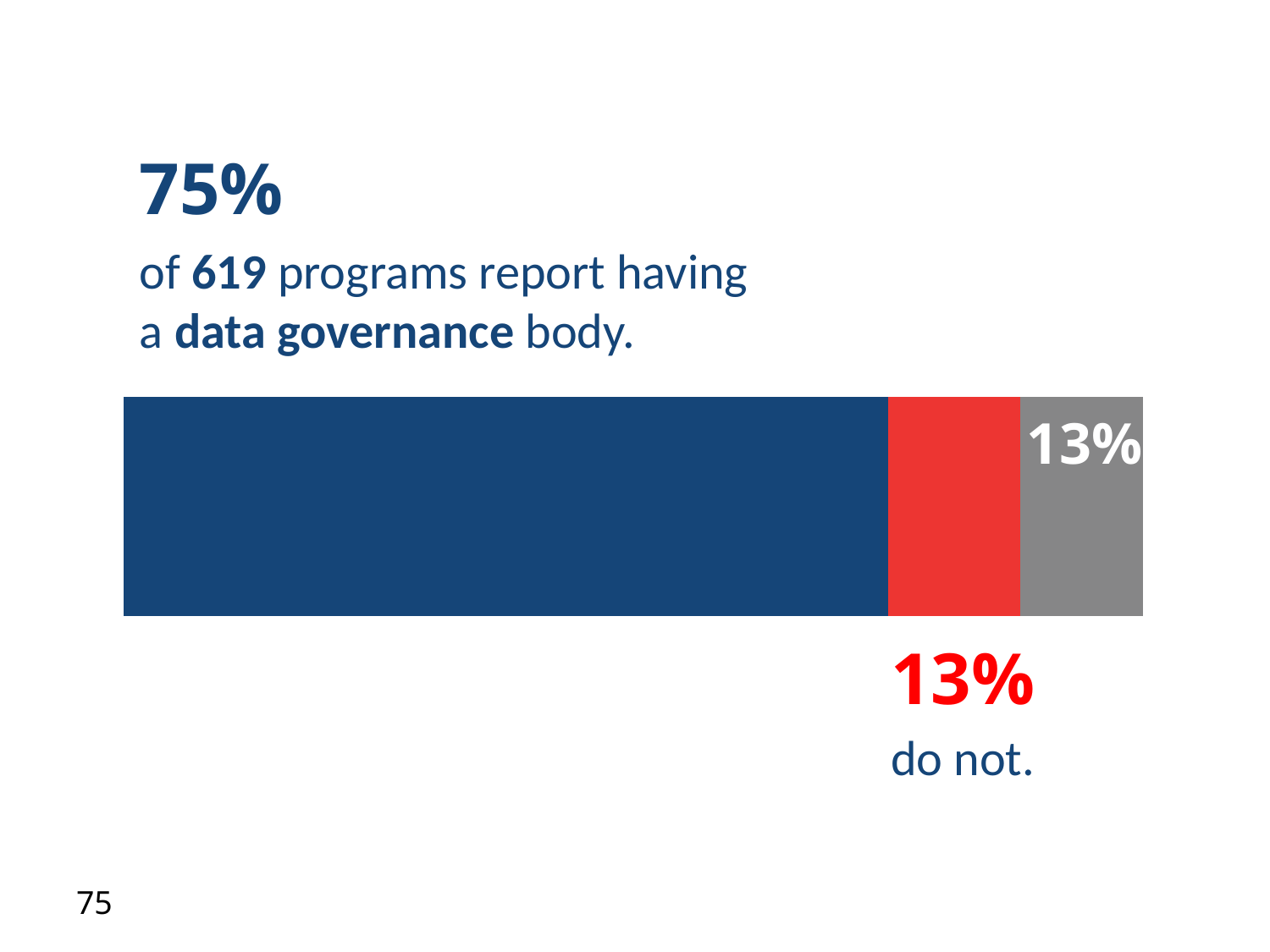
What kind of chart is shown on the slide? bar chart How many segments make up the bar? 3 Which is larger: the share of programs with a data governance body or the share that do not? the share with a data governance body (75%) What is the difference between the share of programs with a data governance body and the share that do not? 62 percentage points What percentage of programs report having a data governance body? 75% What colour is the segment representing programs that do not have a data governance body? red What value is printed on the grey segment of the bar? 13% What percentage of programs do not have a data governance body? 13% How many programs does the chart cover? 619 Which segment of the bar is the largest? the blue segment (75%, programs having a data governance body) What colour is the segment representing the 75% of programs with a data governance body? blue